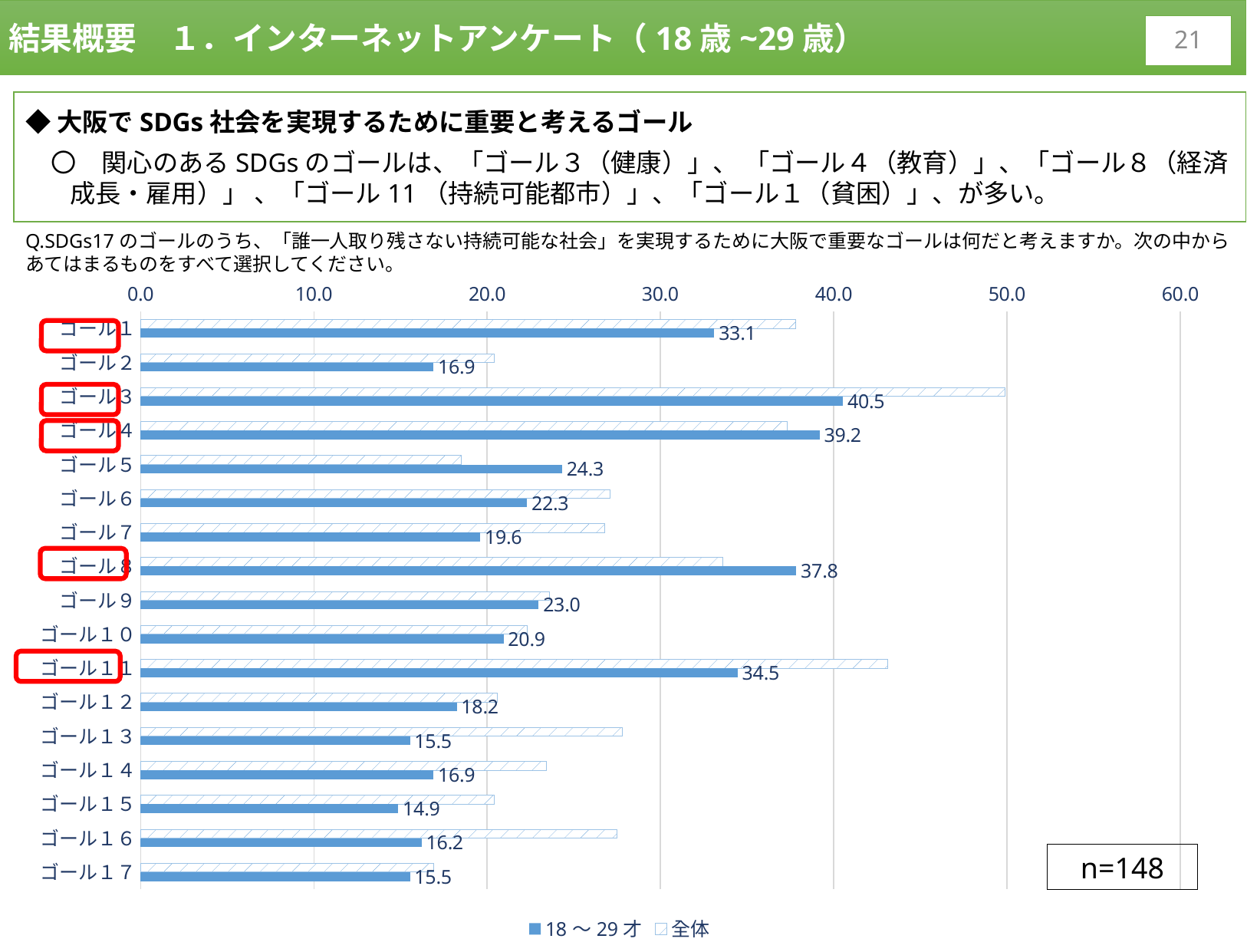
Which series is drawn with a hatched pattern in the legend? 全体 Is the 全体 value for ゴール3 greater or less than 40.0? greater In the 18～29才 series, which is larger: ゴール1 or ゴール11? ゴール11 How many series does the legend list? 2 What is the value for ゴール11 in the 18～29才 series? 34.5 Which goal has the highest value in the 18～29才 series? ゴール3 What is the value for ゴール3 in the 18～29才 series? 40.5 What is the difference between the 18～29才 values for ゴール3 and ゴール4? 1.3 What kind of chart is shown on the slide? bar chart Which goal has the lowest value in the 18～29才 series? ゴール15 What is the value for ゴール8 in the 18～29才 series? 37.8 How many goal categories are plotted on the chart? 17